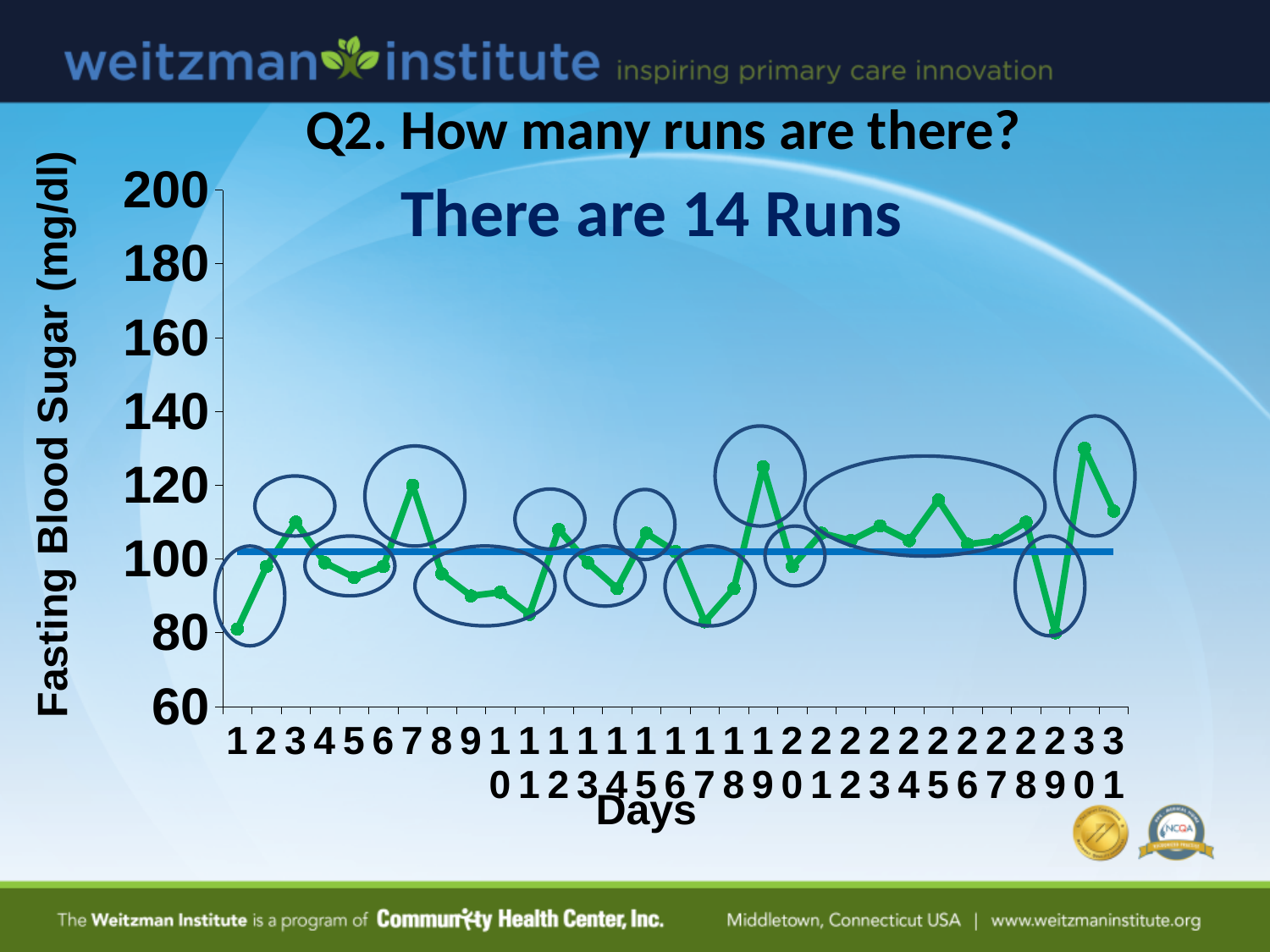
Is the value for day 29 greater or less than 100? less Is the value for day 1 greater or less than 100? less According to the slide, how many runs are there in the chart? 14 What kind of chart is shown on the slide? line chart Is the value for day 17 greater or less than 100? less Which is larger, the value for day 7 or the value for day 1? day 7 How many days (data points) are plotted on the x axis? 31 Which is larger, the value for day 29 or the value for day 30? day 30 What is the label of the y axis? Fasting Blood Sugar (mg/dl)